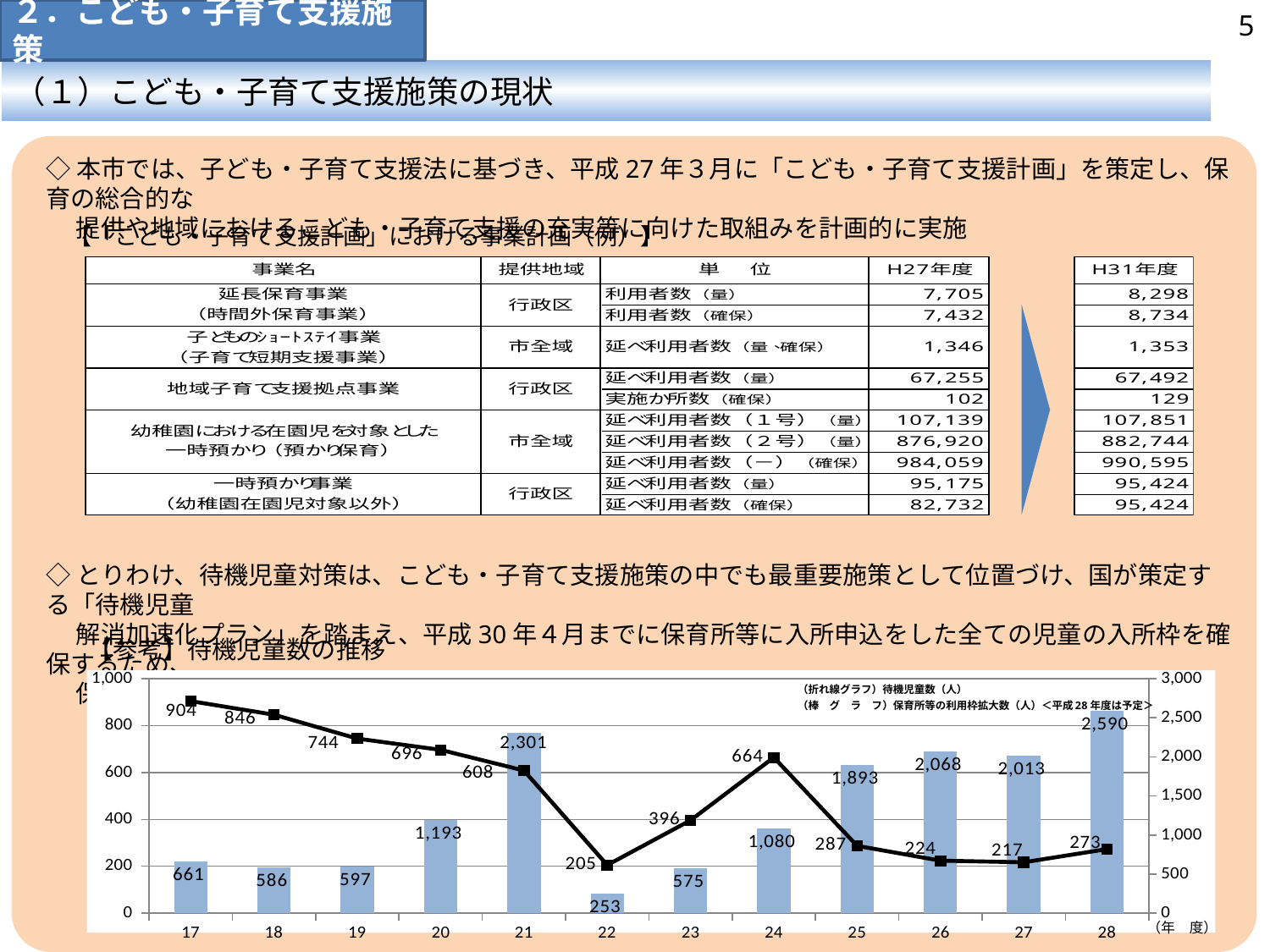
「待機児童数の推移」のグラフで、平成17年度から平成21年度にかけて待機児童数は増加していますか、減少していますか。 減少 「待機児童数の推移」のグラフで、待機児童数（折れ線グラフ）が最も少ない年度はどれですか。 22 「待機児童数の推移」のグラフで、平成28年度の保育所等の利用枠拡大数（棒グラフ）はいくつですか。 2,590 「待機児童数の推移」のグラフで、保育所等の利用枠拡大数（棒グラフ）が最も多い年度はどれですか。 28 「待機児童数の推移」のグラフで、保育所等の利用枠拡大数（棒グラフ）が最も少ない年度はどれですか。 22 「待機児童数の推移」のグラフで、平成23年度と平成24年度では、待機児童数はどちらが多いですか。 24 「待機児童数の推移」のグラフで、棒グラフは何を表していますか。 保育所等の利用枠拡大数（人） 「待機児童数の推移」のグラフで、平成17年度の待機児童数（折れ線グラフ）はいくつですか。 904 「待機児童数の推移」のグラフで、平成20年度の保育所等の利用枠拡大数は1,000より多いですか、少ないですか。 多い 「待機児童数の推移」のグラフで、平成25年度と平成26年度の保育所等の利用枠拡大数の差はいくつですか。 175 「待機児童数の推移」のグラフには、何年度分のデータが表示されていますか。 12 「待機児童数の推移」のグラフで、平成21年度と平成22年度の待機児童数の差はいくつですか。 403